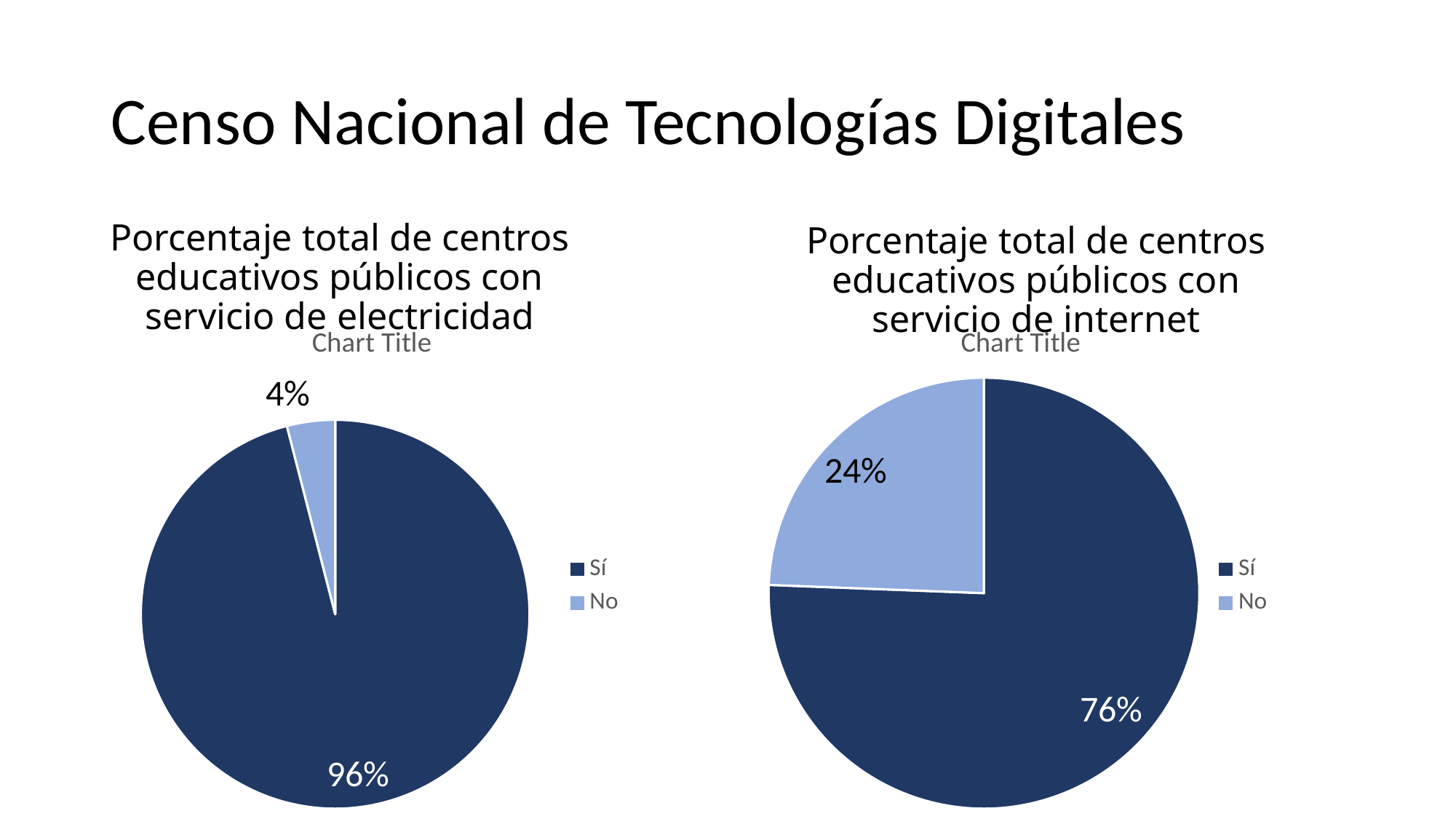
In the right chart (servicio de internet), what colour is the Sí slice? Dark blue In the left chart (servicio de electricidad), what percentage of public schools answered Sí? 96% In the left chart (servicio de electricidad), which category has the smallest slice? No In the left chart (servicio de electricidad), what percentage of public schools answered No? 4% What type of chart is used on the left (servicio de electricidad)? Pie chart In the right chart (servicio de internet), what percentage of public schools answered No? 24% Which is larger: the No share in the left chart (electricidad) or the No share in the right chart (internet)? The No share in the right chart (internet) How many slices does the right chart (servicio de internet) have? 2 In the right chart (servicio de internet), what percentage of public schools answered Sí? 76% In the right chart (servicio de internet), what is the difference between the Sí and No percentages? 52% How many entries does the legend of the left chart (servicio de electricidad) list? 2 In the right chart (servicio de internet), which category has the largest slice? Sí